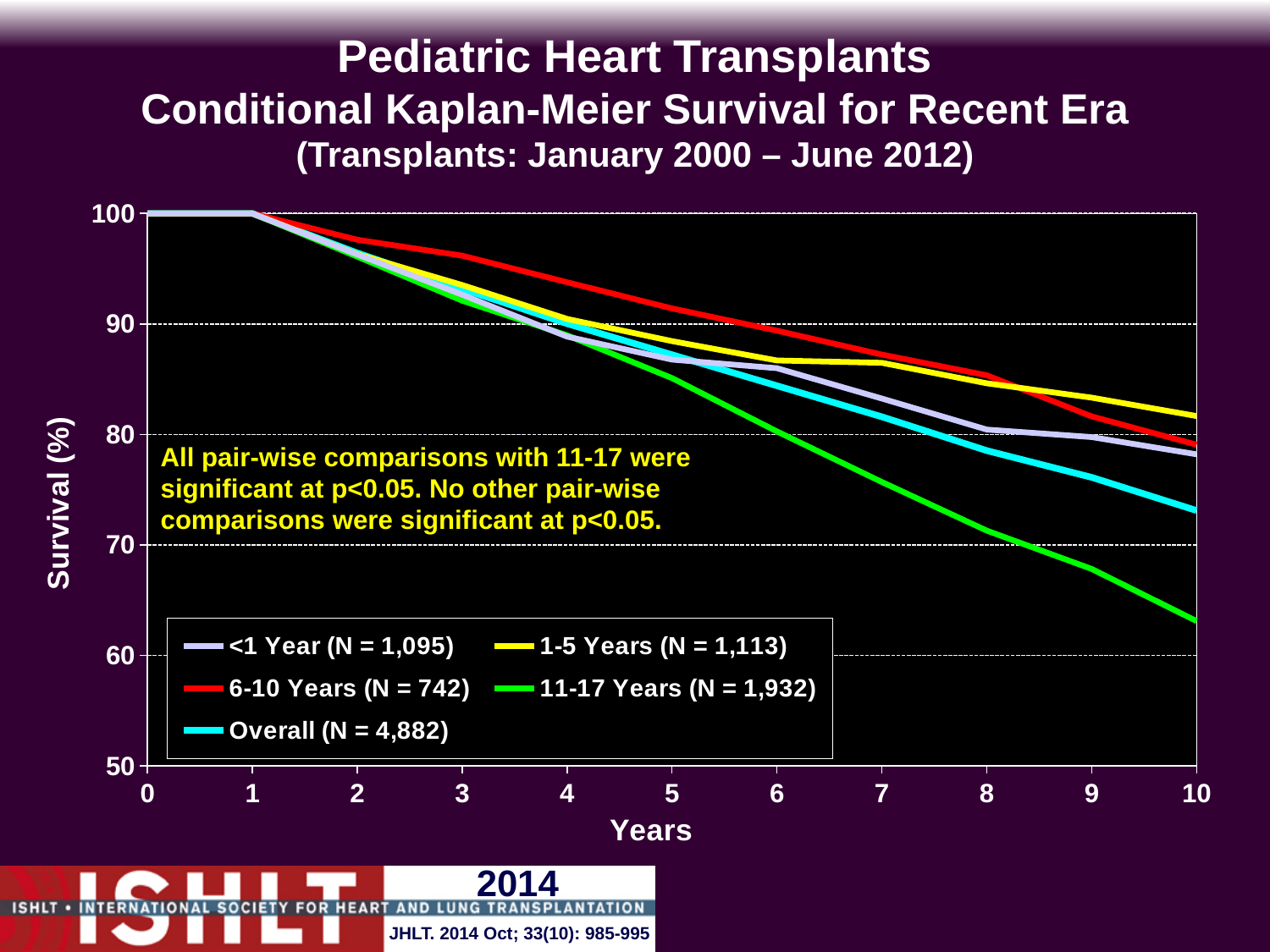
Is the survival value for 11-17 Years at 5 years greater or less than 90? less Which age group has the highest survival at 10 years? 1-5 Years What is the N for the 11-17 Years group shown in the legend? 1,932 What is the survival value for all groups at year 0? 100 What kind of chart is shown on the slide? line chart At 10 years, which has higher survival: 1-5 Years or 11-17 Years? 1-5 Years How many series does the legend list? 5 Do the survival curves rise or fall as years increase? fall Is the survival value for 6-10 Years at 3 years greater or less than 90? greater Which age group has the lowest survival at 10 years? 11-17 Years Is the survival value for 11-17 Years at 10 years greater or less than 70? less